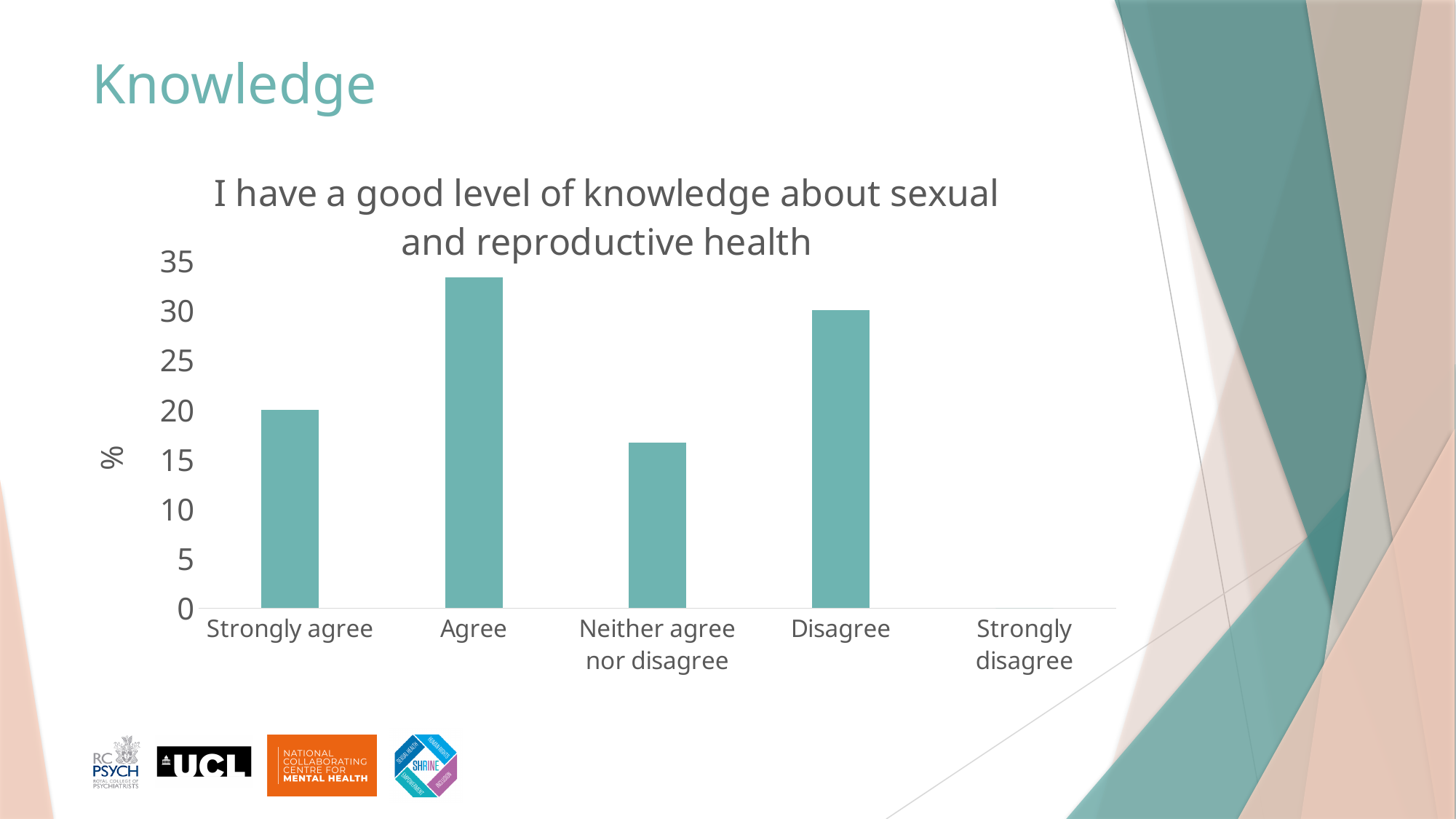
Which response category has the lowest value in the chart? Strongly disagree How many response categories are shown on the x axis of the chart? 5 Which is larger, the value for Agree or the value for Disagree? Agree Is the value for Agree greater or less than 30? greater Is the value for Neither agree nor disagree greater or less than 20? less Which response category has the highest bar in the chart? Agree Is the value for Strongly agree greater or less than 15? greater What is the label on the y axis of the chart? % What kind of chart is shown on the slide? bar chart Which is larger, the value for Strongly agree or the value for Neither agree nor disagree? Strongly agree What is the title of the chart? I have a good level of knowledge about sexual and reproductive health